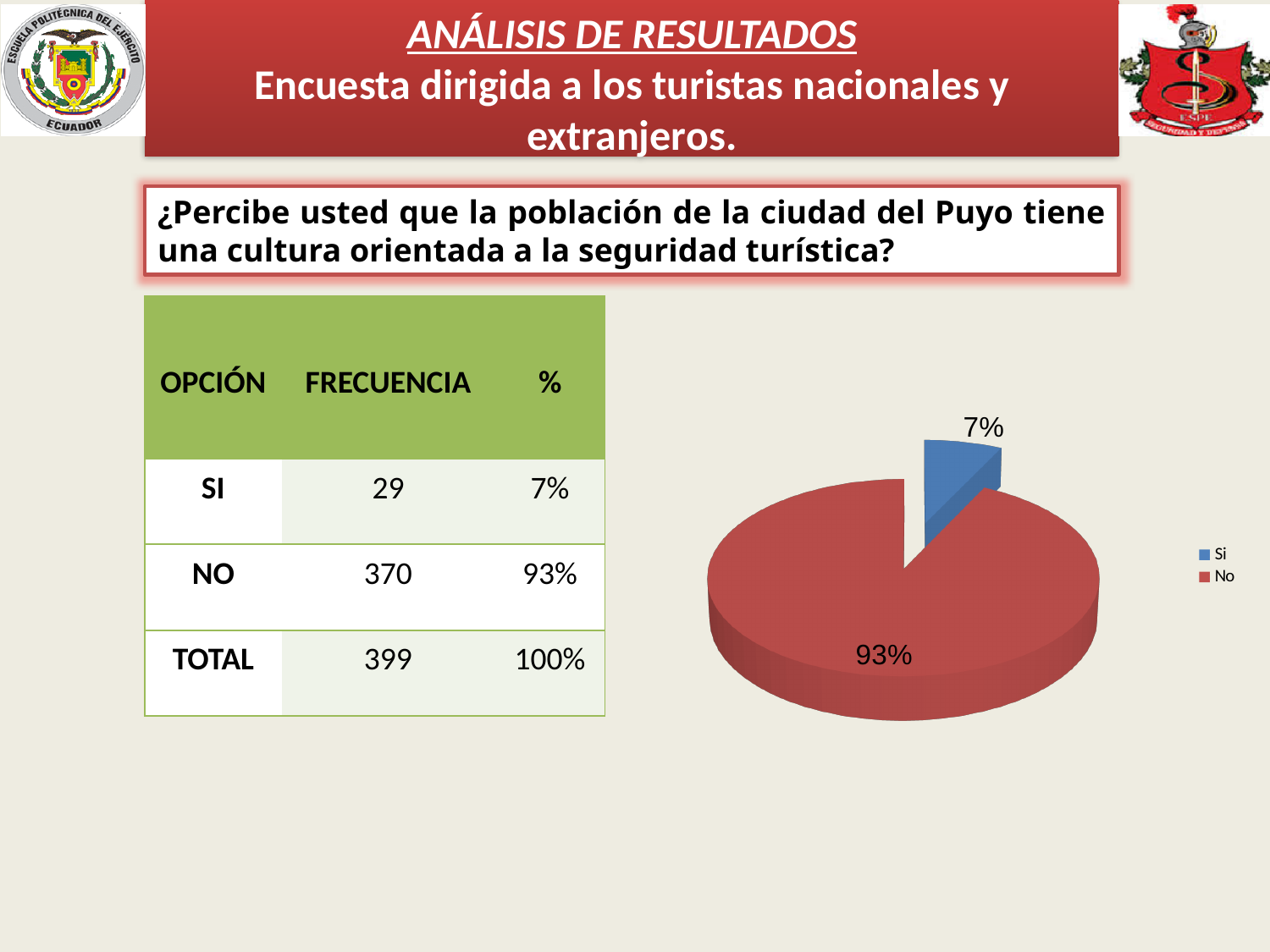
What share of the pie chart does the "Si" slice represent? 7% How many entries does the legend of the pie chart list? 2 What colour is the "No" slice in the pie chart? red How many slices does the pie chart have? 2 What is the difference in percentage points between the "No" slice and the "Si" slice in the pie chart? 86 Which is larger in the pie chart, the "Si" slice or the "No" slice? No Which slice of the pie chart is the largest? No What colour is the "Si" slice in the pie chart? blue What share of the pie chart does the "No" slice represent? 93% What kind of chart is shown on the slide? pie chart Which slice of the pie chart is the smallest? Si